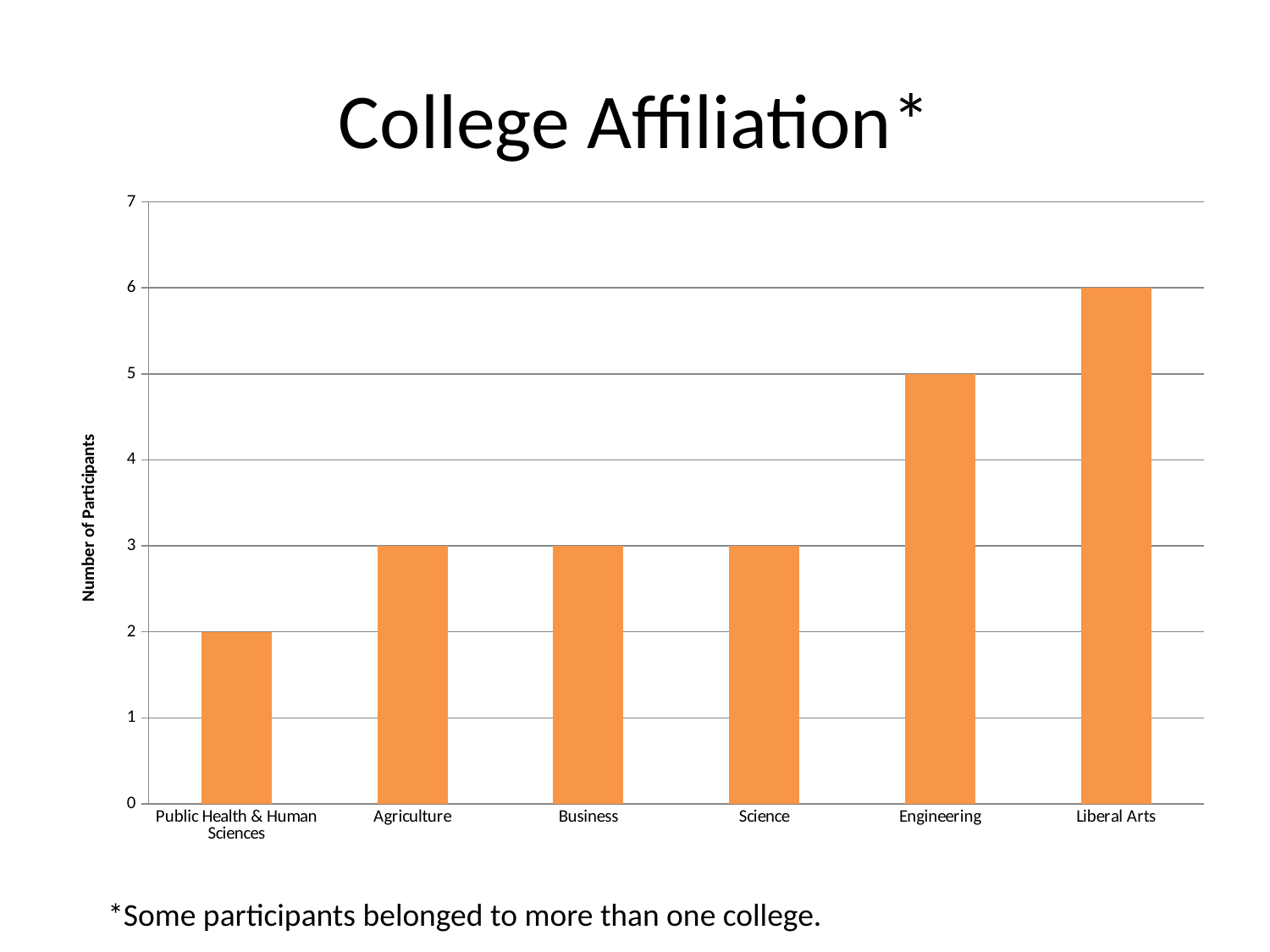
What is the number of participants for Public Health & Human Sciences? 2 Which college has the lowest number of participants? Public Health & Human Sciences What kind of chart is shown on the slide? bar chart How many colleges are shown on the x axis? 6 Is the value for Liberal Arts greater or less than 4? greater What is the number of participants for Liberal Arts? 6 What is the number of participants for Engineering? 5 What is the difference in number of participants between Liberal Arts and Engineering? 1 What is the difference in number of participants between Engineering and Public Health & Human Sciences? 3 Which college has the highest number of participants? Liberal Arts What is the title of the chart? College Affiliation* Which has more participants, Engineering or Agriculture? Engineering